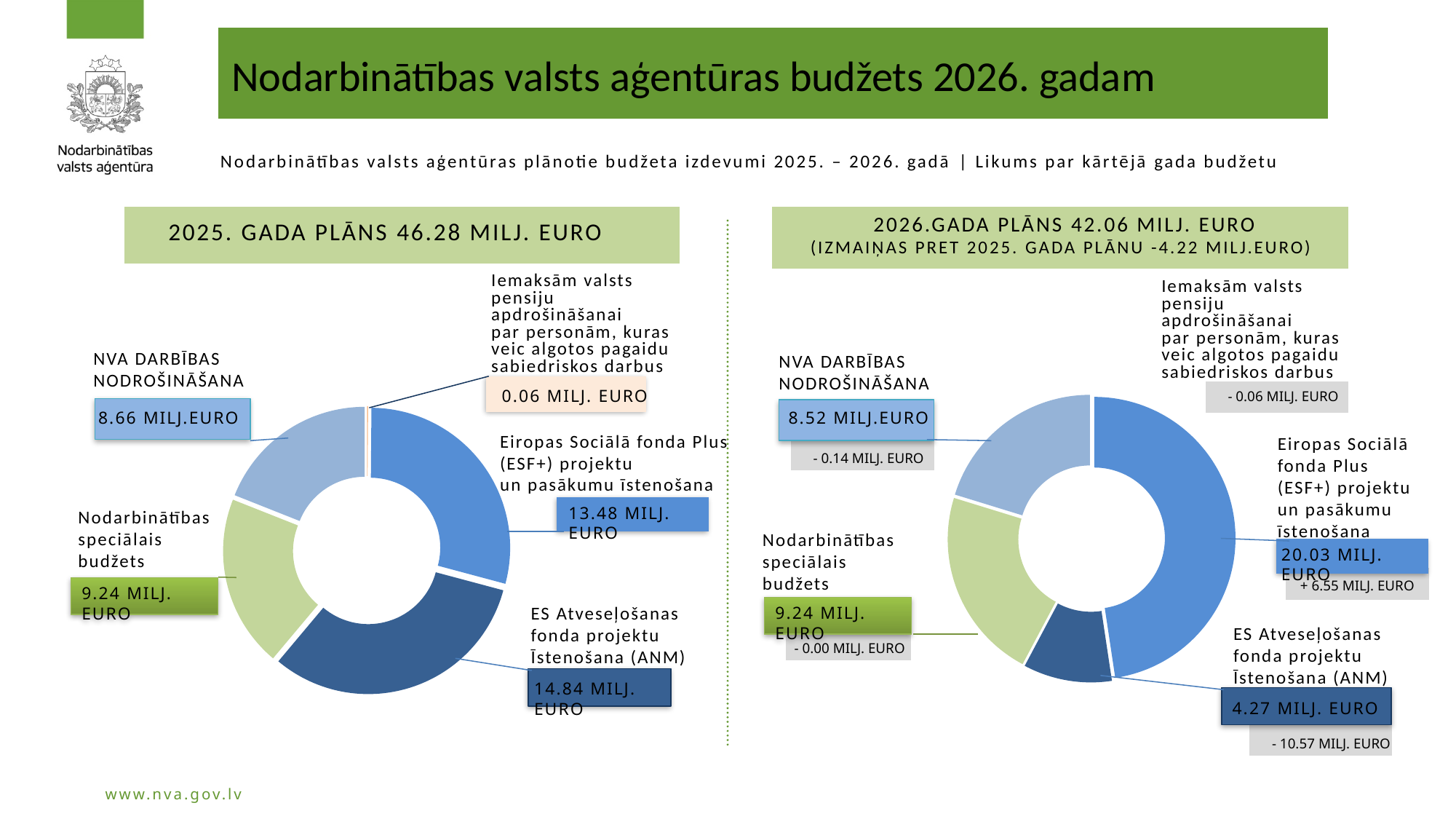
In the 2025 plan chart, which category has the smallest value? Iemaksām valsts pensiju apdrošināšanai par personām, kuras veic algotos pagaidu sabiedriskos darbus In the 2025 plan chart, what is the value for ES Atveseļošanas fonda projektu īstenošana (ANM)? 14.84 MILJ. EURO What is the total of the 2026 plan shown in the right chart's title? 42.06 MILJ. EURO How many categories are labelled in the 2025 plan chart? 5 In the 2026 plan chart, which category has the largest value? Eiropas Sociālā fonda Plus (ESF+) projektu un pasākumu īstenošana In the 2026 plan chart, what is the value for NVA darbības nodrošināšana? 8.52 MILJ.EURO What type of chart is used on the left side of the slide for the 2025 plan? Doughnut (pie) chart In the 2025 plan chart, which is larger: NVA darbības nodrošināšana or Nodarbinātības speciālais budžets? Nodarbinātības speciālais budžets In the 2026 plan chart, what is the change for ES Atveseļošanas fonda projektu īstenošana (ANM) compared with the 2025 plan? - 10.57 MILJ. EURO In the 2026 plan chart, what is the difference between the ESF+ value and the NVA darbības nodrošināšana value? 11.51 MILJ. EURO In the 2025 plan chart, what is the value for Eiropas Sociālā fonda Plus (ESF+) projektu un pasākumu īstenošana? 13.48 MILJ. EURO In the 2025 plan chart, what is the difference between the ANM value and the ESF+ value? 1.36 MILJ. EURO